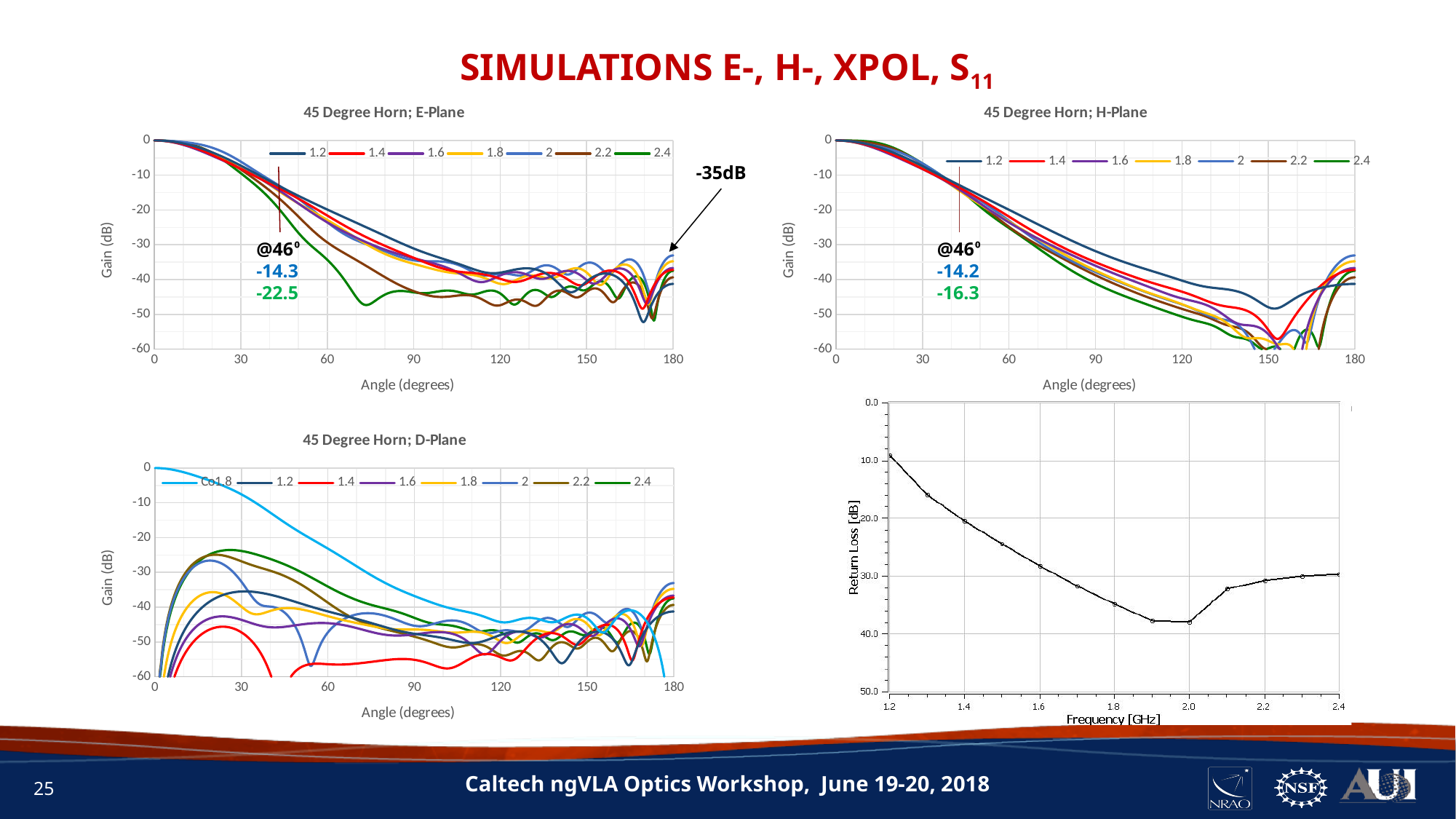
On the '45 Degree Horn; E-Plane' chart, what is the difference between the two annotated gain values at 46 degrees (-14.3 and -22.5)? 8.2 On the '45 Degree Horn; D-Plane' chart, how many series does the legend list? 8 On the '45 Degree Horn; E-Plane' chart, how many series does the legend list? 7 On the '45 Degree Horn; E-Plane' chart, what two gain values are annotated at 46 degrees? -14.3 and -22.5 What kind of chart is the Return Loss chart at the bottom right of the slide? line chart On the '45 Degree Horn; H-Plane' chart, what two gain values are annotated at 46 degrees? -14.2 and -16.3 On the '45 Degree Horn; E-Plane' chart, what gain level does the arrow near 180 degrees point to? -35dB What is the x-axis label of the Return Loss chart? Frequency [GHz] On the Return Loss chart, is the return loss value at 2.0 GHz greater or less than 30? greater On the '45 Degree Horn; D-Plane' chart, which legend entry corresponds to the light blue (cyan) line? Co1.8 On the '45 Degree Horn; H-Plane' chart, what is the difference between the two annotated gain values at 46 degrees (-14.2 and -16.3)? 2.1 On the Return Loss chart, is the return loss value at 1.3 GHz greater or less than 20? less